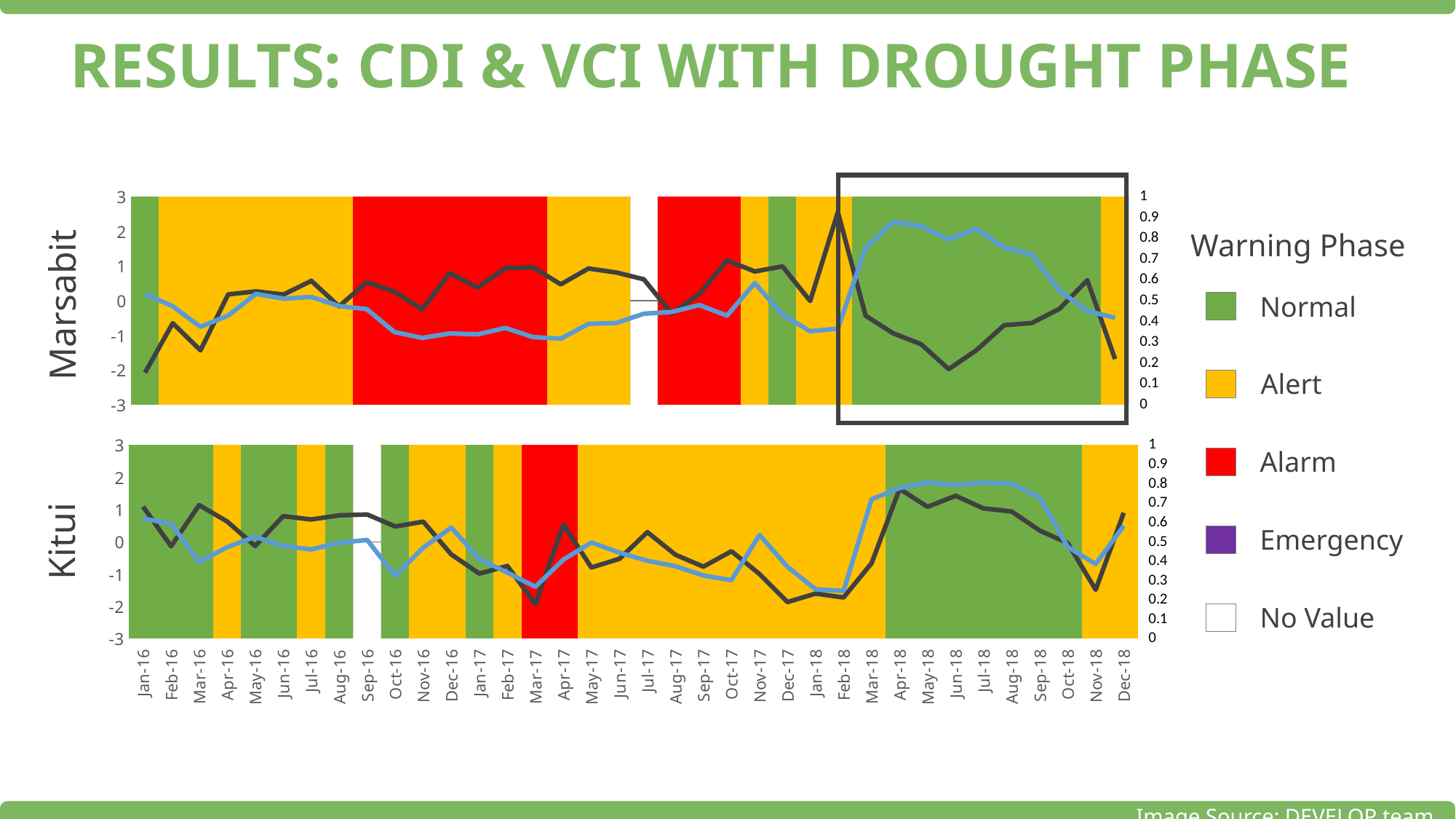
Which colour represents the Alarm warning phase in the legend? red In the Marsabit chart, is the value of the black line at Feb-18 greater or less than 2 on the left axis? greater In the Kitui chart, does the blue line rise or fall between Feb-18 and Apr-18? rise How many warning phases does the legend list? 5 How many monthly points are shown along the x axis, from Jan-16 to Dec-18? 36 In the Kitui chart, is the value of the black line at Dec-17 greater or less than -1 on the left axis? less In the Kitui chart, is the value of the black line at Mar-17 greater or less than -1 on the left axis? less Which of the two charts has a black rectangle highlighting the 2018 period? Marsabit In the Marsabit chart, does the blue line rise or fall between Apr-18 and Dec-18? fall What kind of chart is used for the Marsabit panel? combination bar and line chart